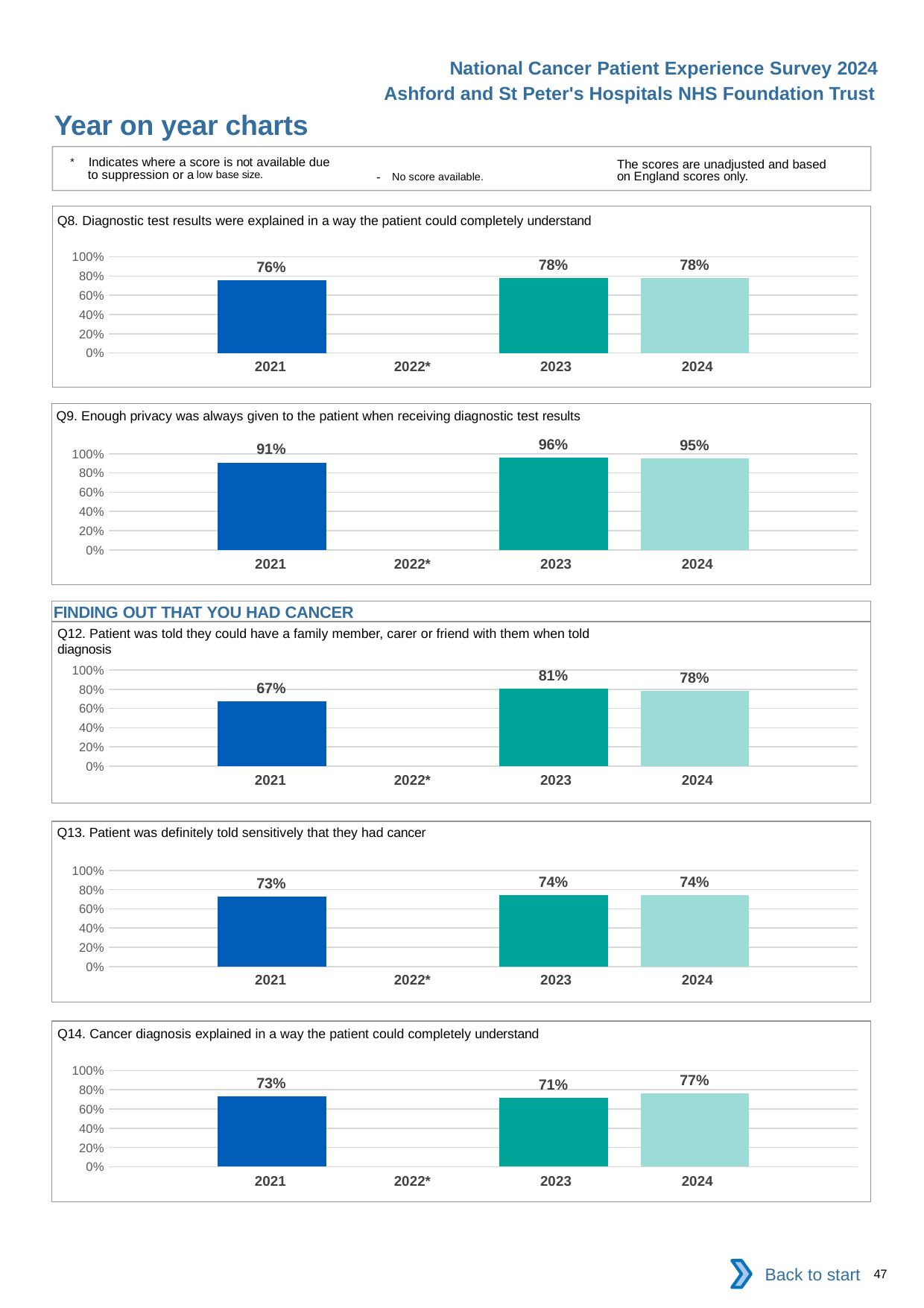
What type of chart is the Q9 chart? Bar chart In the Q8 chart, is the value for 2024 greater or less than 60%? greater In the Q14 chart (Cancer diagnosis explained in a way the patient could completely understand), which is larger, the 2023 value or the 2024 value? 2024 In the Q12 chart (Patient was told they could have a family member, carer or friend with them when told diagnosis), what is the difference between the 2023 and 2021 values? 14% In the Q8 chart (Diagnostic test results were explained in a way the patient could completely understand), what is the value for 2021? 76% In the Q12 chart, which year is marked with an asterisk indicating no score is available? 2022* How many year categories are shown on the x axis of the Q13 chart? 4 In the Q9 chart (Enough privacy was always given to the patient when receiving diagnostic test results), which year has the highest value? 2023 In the Q13 chart (Patient was definitely told sensitively that they had cancer), what is the value for 2023? 74% In the Q14 chart, what is the difference between the 2024 and 2023 values? 6% In the Q12 chart, which year has the lowest value? 2021 In the Q9 chart, what is the value for 2024? 95%